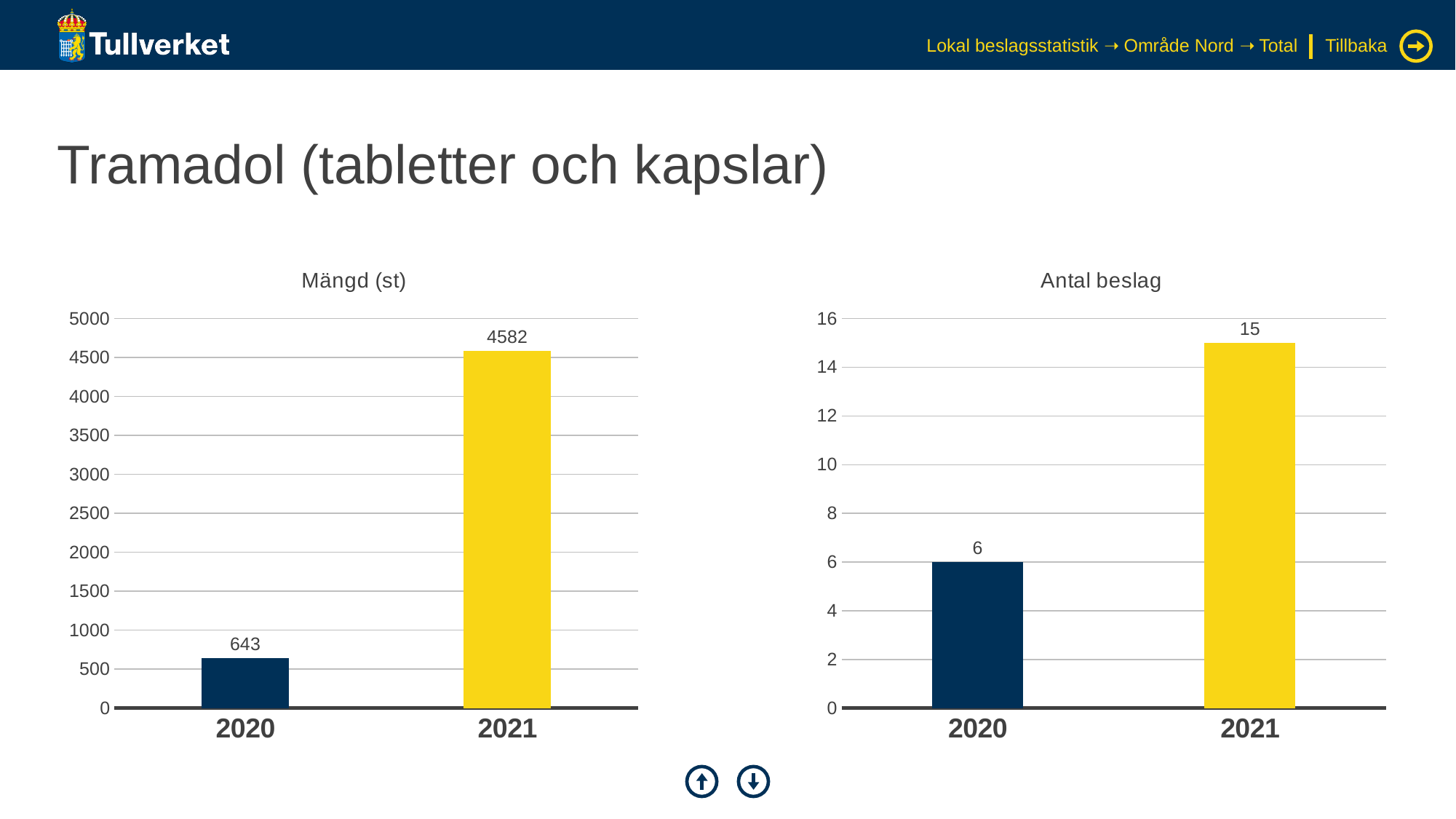
In the 'Antal beslag' chart, is the value for 2020 greater or less than 8? less In the 'Mängd (st)' chart, what is the difference between the 2021 and 2020 values? 3939 In the 'Mängd (st)' chart, do the values rise or fall from 2020 to 2021? rise In the 'Antal beslag' chart, what is the value for 2021? 15 In the 'Mängd (st)' chart, how many years are shown on the x axis? 2 In the 'Antal beslag' chart, which year has the lowest value? 2020 In the 'Mängd (st)' chart, what is the value for 2021? 4582 What kind of chart is the 'Antal beslag' chart? bar chart In the 'Mängd (st)' chart, which year has the highest value? 2021 In the 'Mängd (st)' chart, what is the value for 2020? 643 In the 'Antal beslag' chart, what is the value for 2020? 6 In the 'Antal beslag' chart, what is the difference between the 2021 and 2020 values? 9